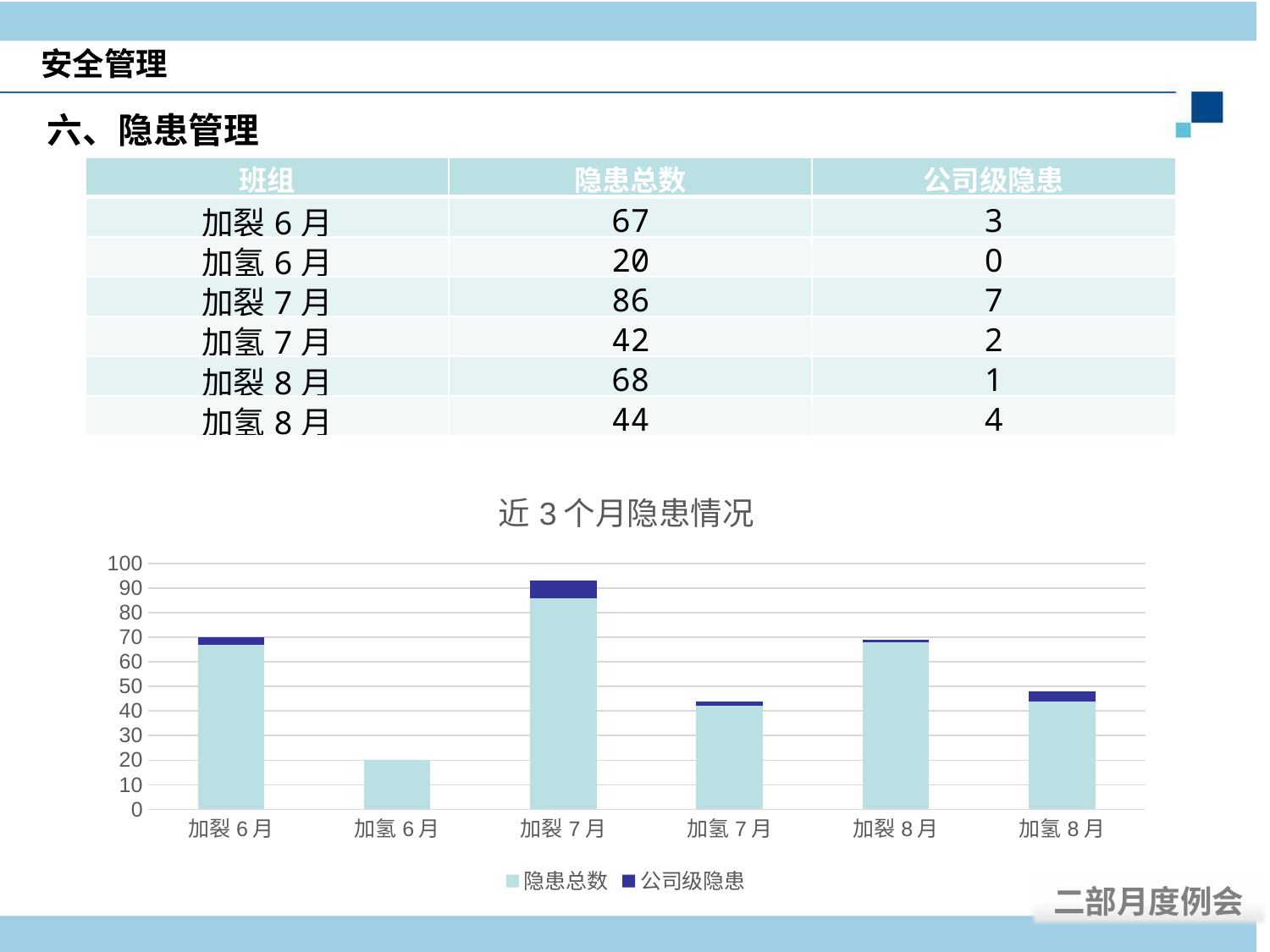
What is the 公司级隐患 value for 加氢8月? 4 What is the difference between the 隐患总数 values for 加裂7月 and 加裂6月? 19 Which has the larger 隐患总数, 加裂8月 or 加氢8月? 加裂8月 What is the total height of the stacked bar for 加裂7月 (隐患总数 plus 公司级隐患)? 93 Which category has the highest 隐患总数 in the chart? 加裂7月 How many series does the chart legend list? 2 Which category has the lowest 隐患总数 in the chart? 加氢6月 What is the 隐患总数 value for 加裂7月? 86 What is the title of the chart? 近3个月隐患情况 What kind of chart is shown on the slide? Stacked bar chart Is the 隐患总数 value for 加氢6月 greater or less than 30? less How many categories are shown on the x axis of the chart? 6